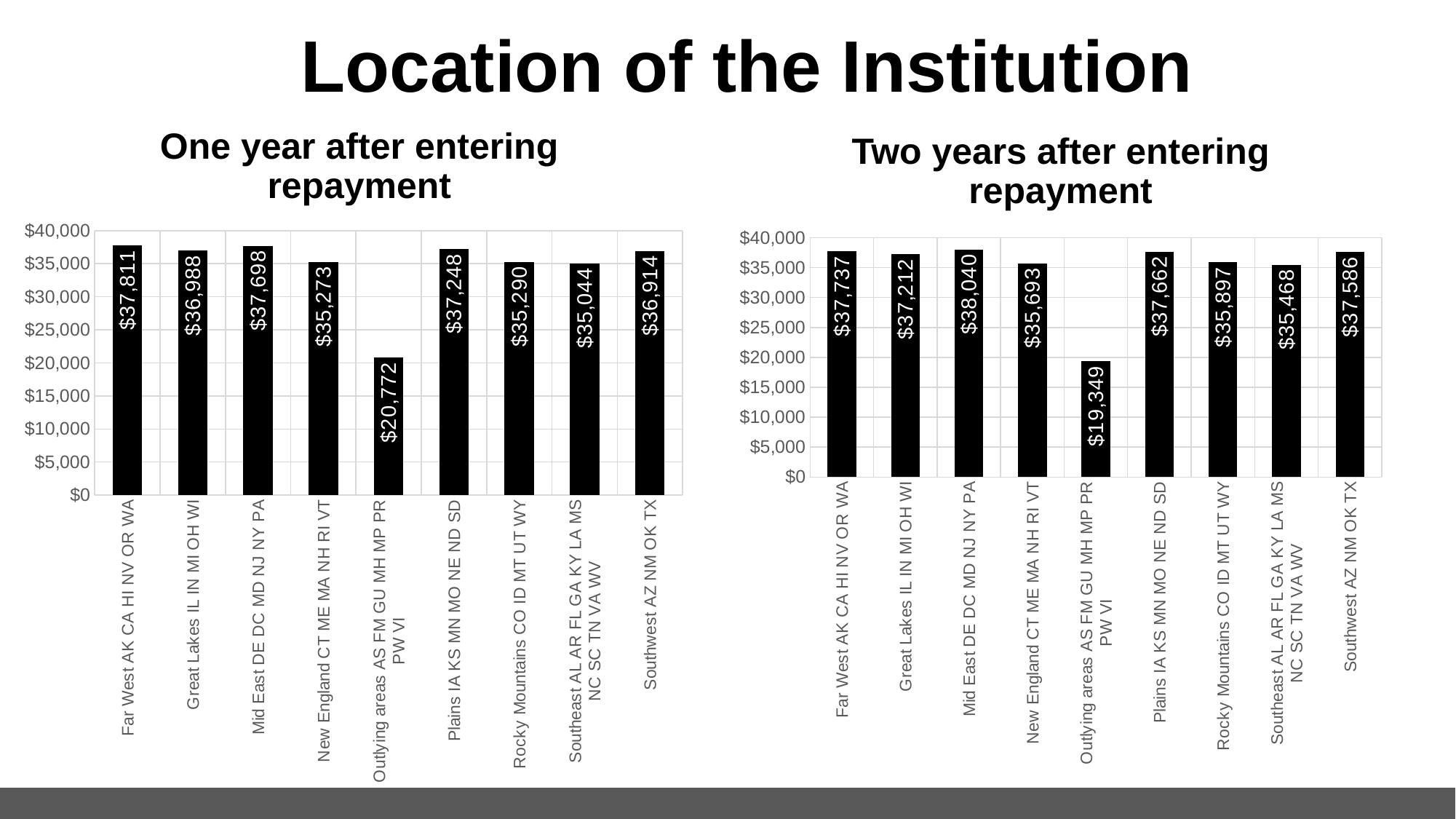
In the 'Two years after entering repayment' chart, what is the value for New England CT ME MA NH RI VT? $35,693 In the 'One year after entering repayment' chart, which category has the lowest value? Outlying areas AS FM GU MH MP PR PW VI In the 'One year after entering repayment' chart, is the value for Outlying areas AS FM GU MH MP PR PW VI greater or less than $25,000? less In the 'One year after entering repayment' chart, what is the value for Mid East DE DC MD NJ NY PA? $37,698 In the 'Two years after entering repayment' chart, what is the value for Outlying areas AS FM GU MH MP PR PW VI? $19,349 In the 'Two years after entering repayment' chart, which category has the highest value? Mid East DE DC MD NJ NY PA What kind of chart is the 'One year after entering repayment' chart? bar chart In the 'One year after entering repayment' chart, what is the value for Far West AK CA HI NV OR WA? $37,811 In the 'Two years after entering repayment' chart, which is larger: Plains IA KS MN MO NE ND SD or Rocky Mountains CO ID MT UT WY? Plains IA KS MN MO NE ND SD What is the title of the slide? Location of the Institution In the 'One year after entering repayment' chart, what is the difference between Far West AK CA HI NV OR WA and Southeast AL AR FL GA KY LA MS NC SC TN VA WV? $2,767 How many categories are shown in the 'Two years after entering repayment' chart? 9